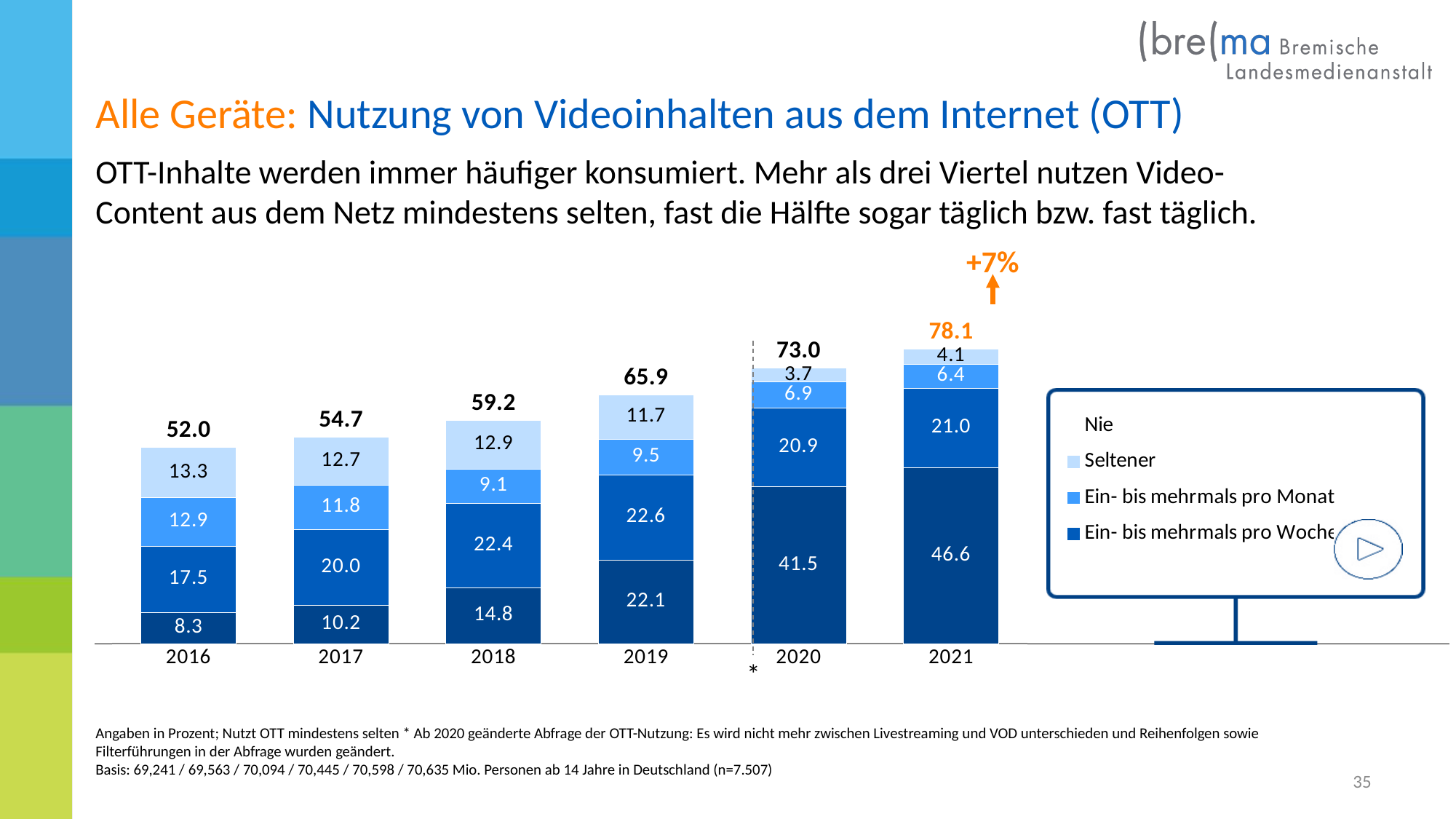
Do the total bar values rise or fall from 2016 to 2021? rise How many years are shown on the x axis? 6 Which year has the highest total bar value? 2021 What is the total value shown above the 2016 bar? 52.0 What percentage change is annotated in orange above the 2021 bar? +7% What is the difference between the total for 2021 and the total for 2020? 5.1 What is the total value shown above the 2021 bar? 78.1 Which year has the lowest total bar value? 2016 What is the value of the 'Seltener' segment for 2019? 11.7 What is the value of the 'Ein- bis mehrmals pro Monat' segment for 2017? 11.8 Which year has the larger 'Seltener' value, 2016 or 2021? 2016 What is the value of the 'Ein- bis mehrmals pro Woche' segment for 2020? 20.9